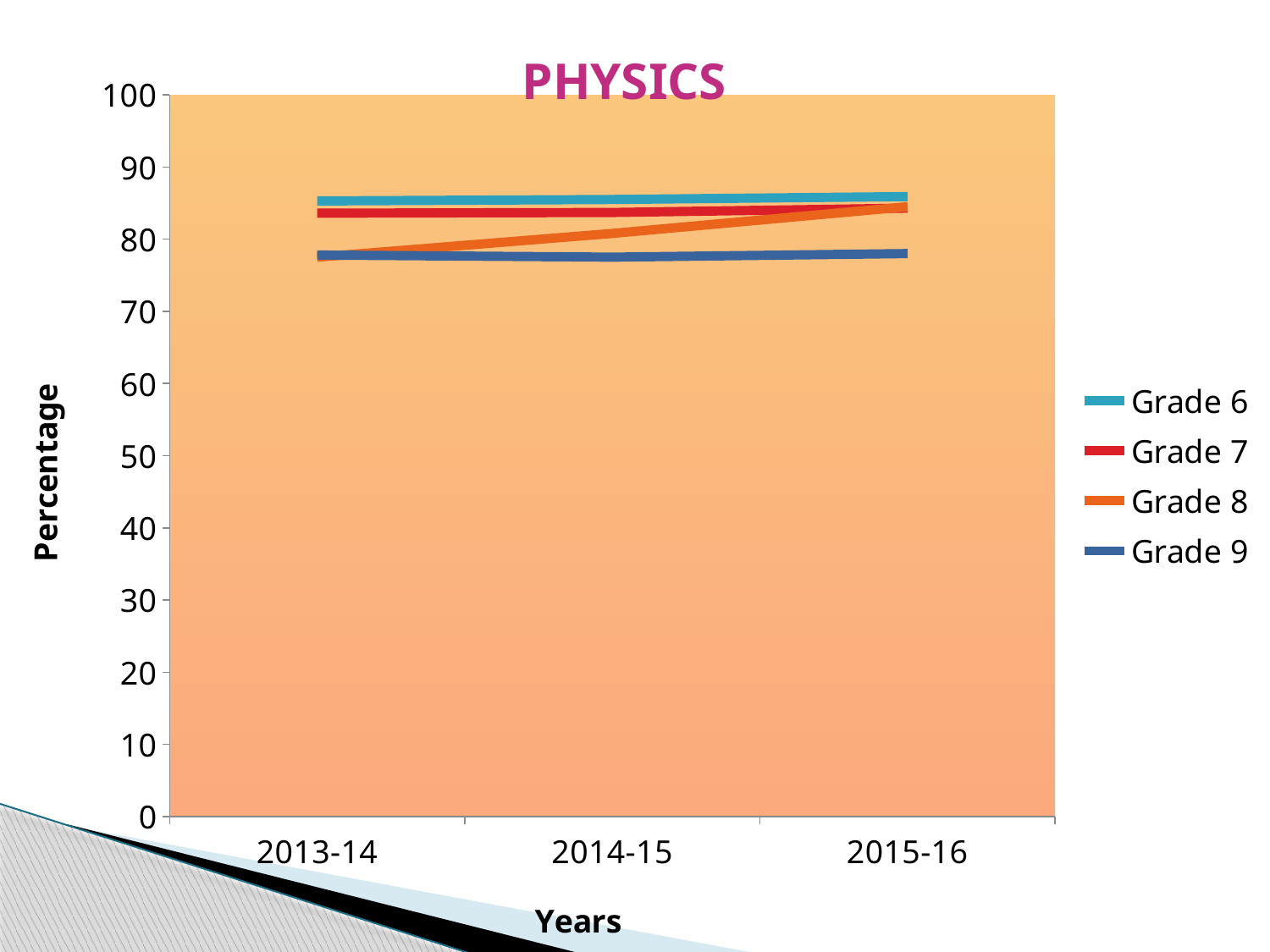
Is the value for Grade 8 in 2013-14 greater or less than 80? less What is the title of the chart? PHYSICS How many series does the legend list? 4 Is the value for Grade 6 in 2013-14 greater or less than 80? greater Is the value for Grade 8 in 2015-16 greater or less than 80? greater What kind of chart is shown on the slide? line chart What is the label of the vertical axis? Percentage How many years are shown on the x axis? 3 Which grade has the lowest value in 2015-16? Grade 9 Does the Grade 8 line rise or fall from 2013-14 to 2015-16? rise Which grade has the highest value in 2013-14? Grade 6